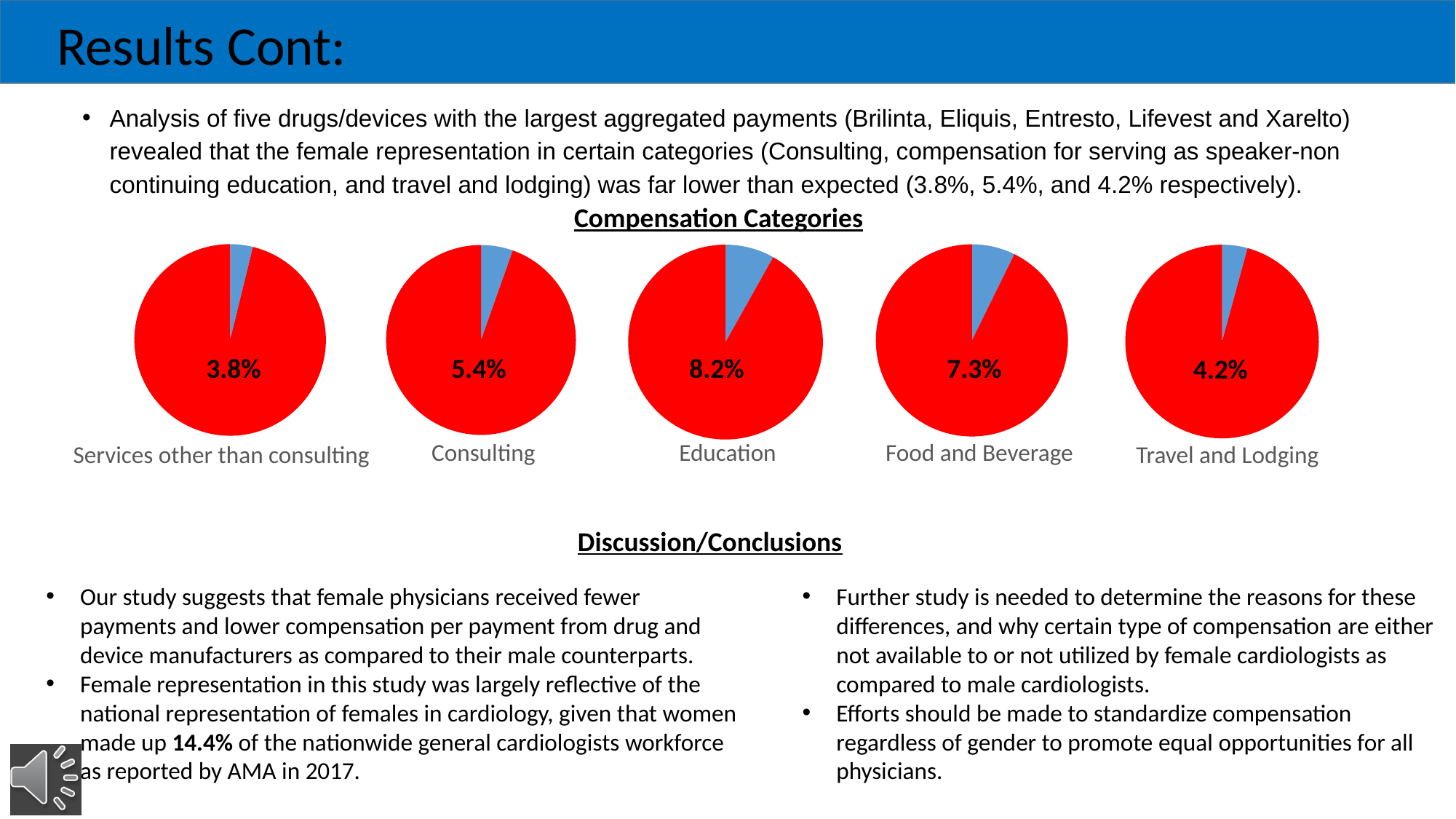
How many pie charts are shown under Compensation Categories? 5 Which pie chart shows a larger percentage, Food and Beverage or Travel and Lodging? Food and Beverage What is the difference between the percentage on the Education pie chart and the percentage on the Services other than consulting pie chart? 4.4 percentage points What kind of charts are shown under the heading Compensation Categories? Pie charts Which compensation category pie chart shows the lowest percentage? Services other than consulting What percentage is printed on the Services other than consulting pie chart? 3.8% What is the title shown above the five pie charts? Compensation Categories What percentage is printed on the Food and Beverage pie chart? 7.3% What percentage is printed on the Education pie chart? 8.2% What percentage is printed on the Travel and Lodging pie chart? 4.2% Which compensation category pie chart shows the highest percentage? Education What percentage is printed on the Consulting pie chart? 5.4%